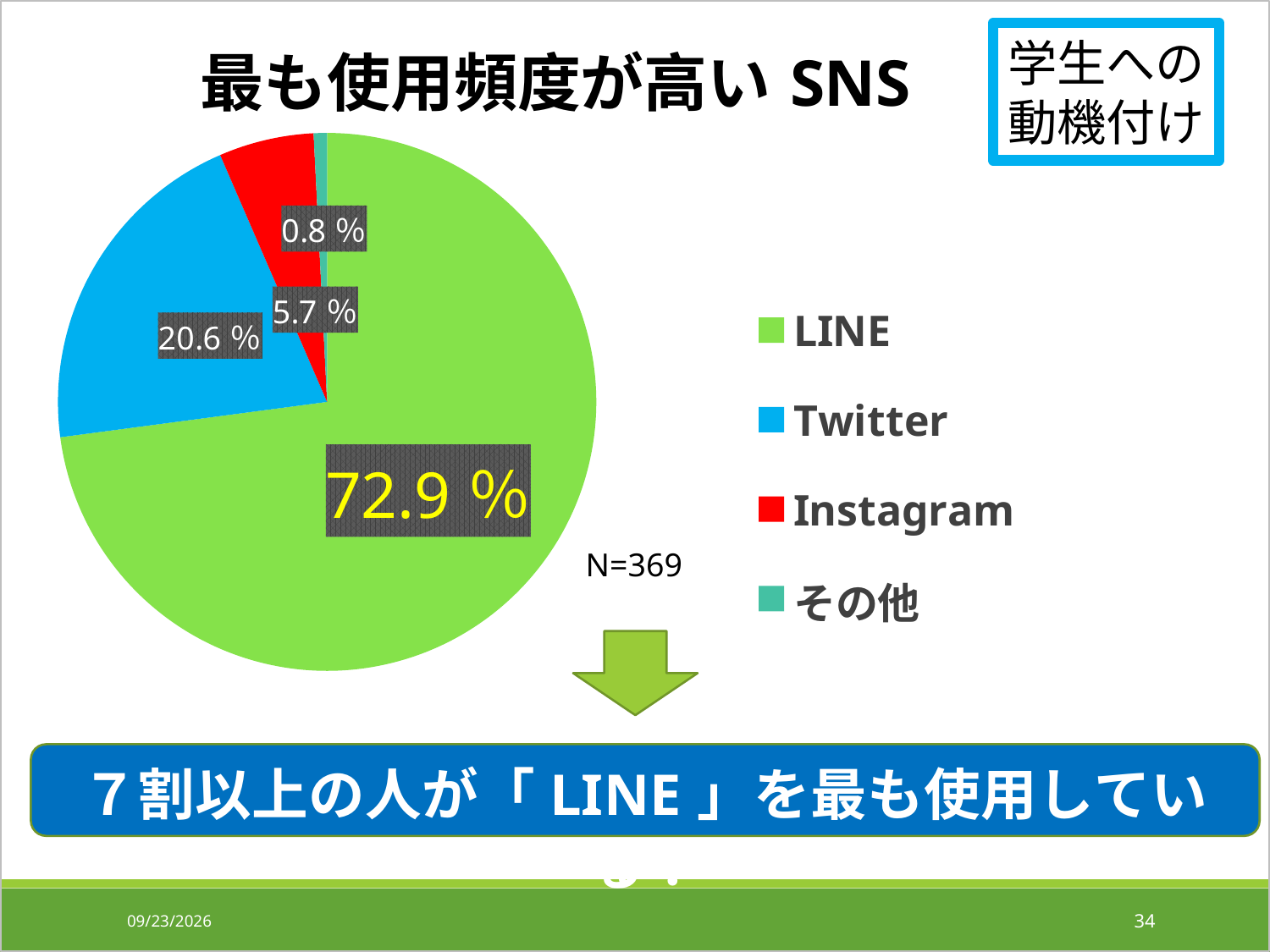
What is the share for その他 in the pie chart? 0.8 % What is the share for Twitter in the pie chart? 20.6 % Which category has the largest slice in the pie chart? LINE Which is larger, the share for Twitter or the share for Instagram? Twitter What is the difference in percentage points between LINE and Twitter? 52.3 What type of chart is shown on the slide? pie chart What is the share for Instagram in the pie chart? 5.7 % What is the share for LINE in the pie chart? 72.9 % How many categories does the pie chart have? 4 What is the title of the chart? 最も使用頻度が高い SNS What is the sample size (N) shown next to the pie chart? N=369 Which category has the smallest slice in the pie chart? その他